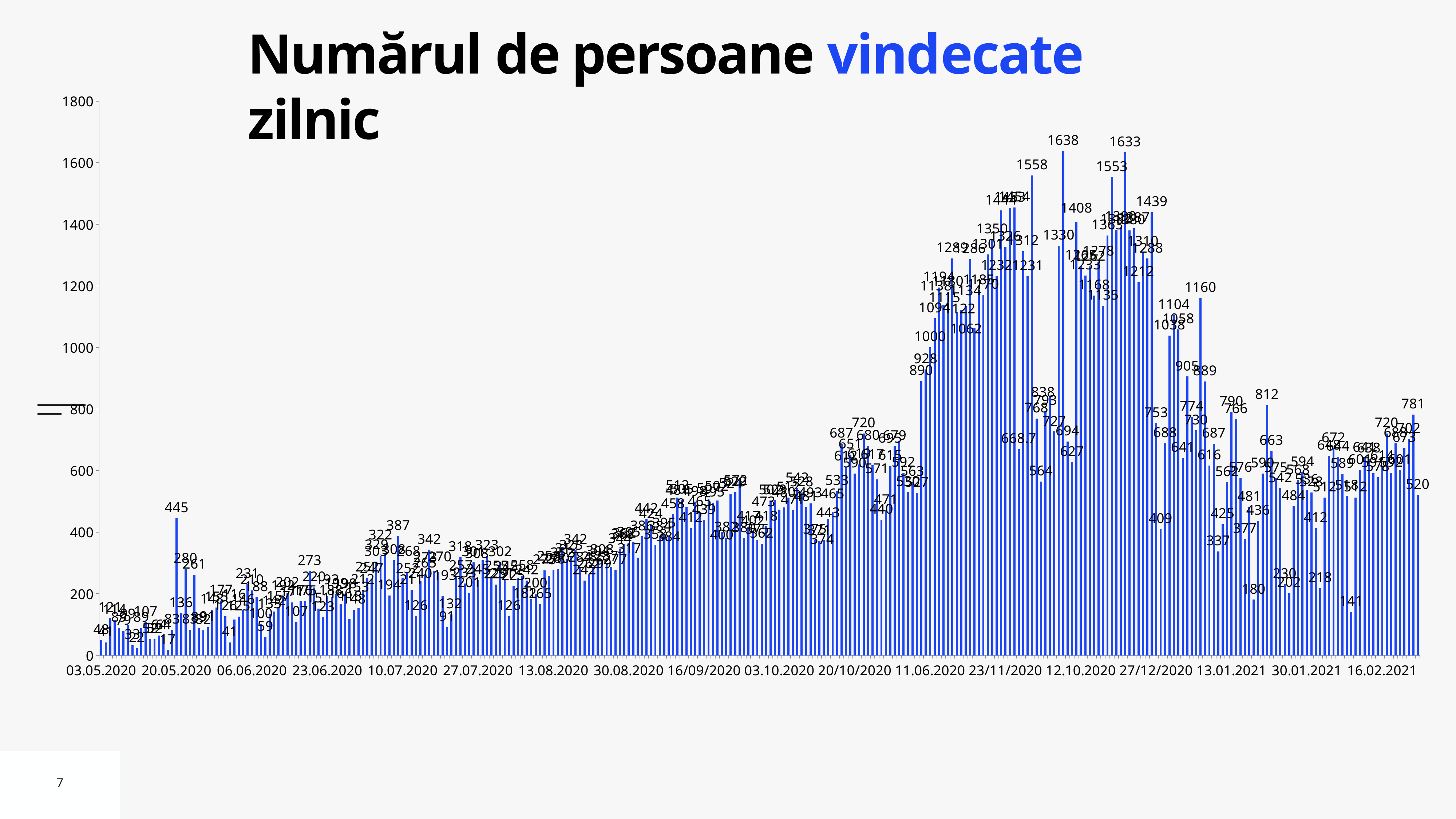
Overall, do the values rise or fall from May 2020 to the end of 2020? rise What is the second-highest value labelled on the chart, near the 1638 peak? 1633 What is the title of the chart? Numărul de persoane vindecate zilnic What is the first date label on the horizontal axis? 03.05.2020 Is the value of the tall bar labelled 445 in May 2020 greater or less than 400? greater What is the highest value shown on the vertical axis? 1800 What is the highest value labelled on the chart? 1638 What kind of chart is shown on the slide? bar chart What is the difference between the bars labelled 1558 and 1553? 5 Which is larger, the bar labelled 1558 or the bar labelled 1553? 1558 What is the last date label on the horizontal axis? 16.02.2021 What is the difference between the two highest labelled values, 1638 and 1633? 5